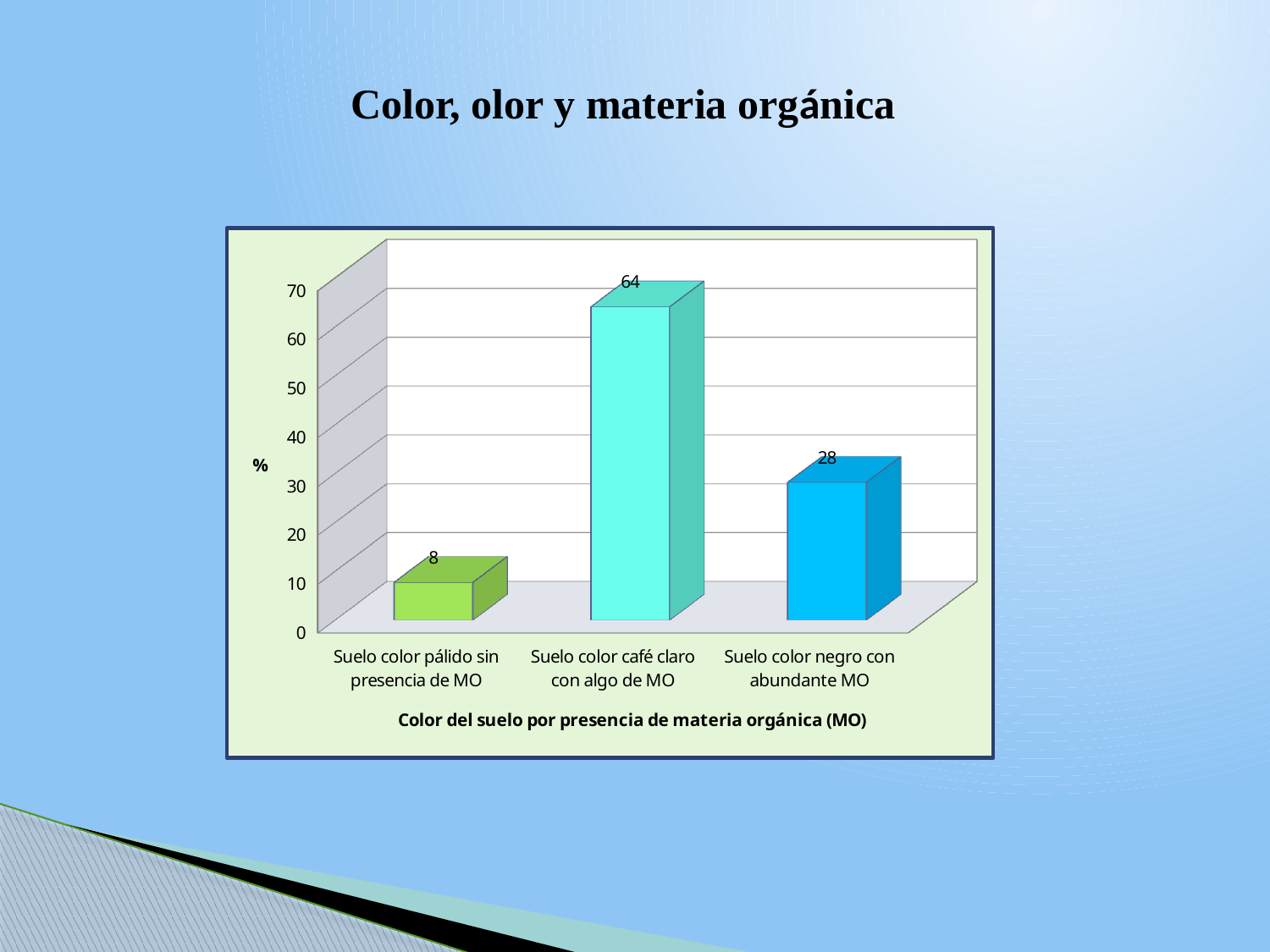
Which is larger: the value for 'Suelo color negro con abundante MO' or 'Suelo color pálido sin presencia de MO'? Suelo color negro con abundante MO What kind of chart is shown on the slide? bar chart What is the label of the x axis? Color del suelo por presencia de materia orgánica (MO) How many categories are shown on the x axis? 3 Which category has the lowest value? Suelo color pálido sin presencia de MO Which category has the highest value? Suelo color café claro con algo de MO What is the value for 'Suelo color pálido sin presencia de MO'? 8 Is the value for 'Suelo color café claro con algo de MO' greater or less than 50? greater What is the difference between the values for 'Suelo color negro con abundante MO' and 'Suelo color pálido sin presencia de MO'? 20 What is the value for 'Suelo color negro con abundante MO'? 28 What is the difference between the values for 'Suelo color café claro con algo de MO' and 'Suelo color negro con abundante MO'? 36 What is the value for 'Suelo color café claro con algo de MO'? 64